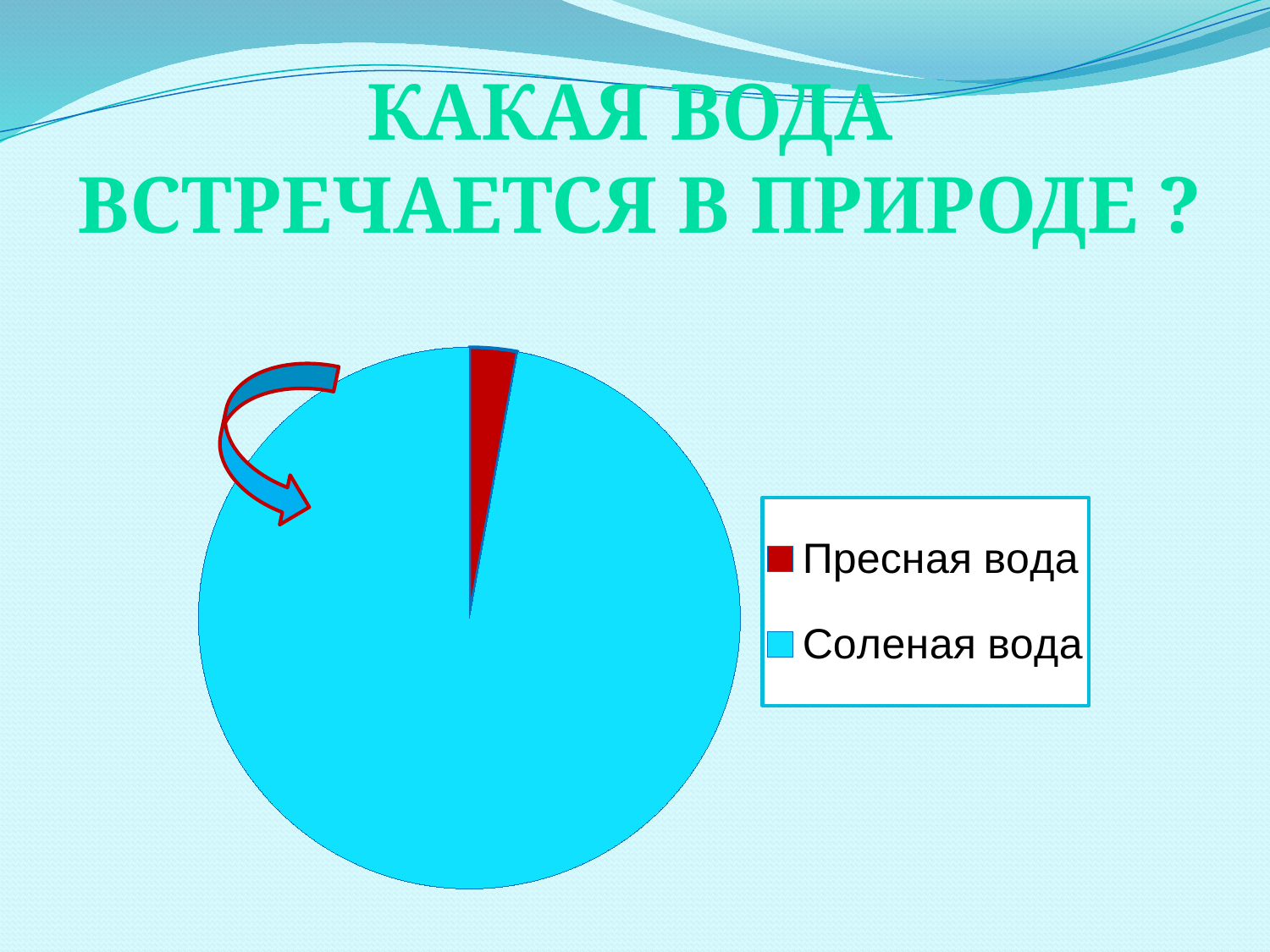
Which category has the smallest slice in the pie chart? Пресная вода What colour is the slice for Пресная вода in the pie chart? red Does the pie chart show data labels with the values of the slices? No Which category has the largest slice in the pie chart? Соленая вода What colour is the slice for Соленая вода in the pie chart? light blue Which slice is larger in the pie chart, Пресная вода or Соленая вода? Соленая вода What kind of chart is shown on the slide? pie chart How many entries does the legend of the pie chart list? 2 How many slices does the pie chart have? 2